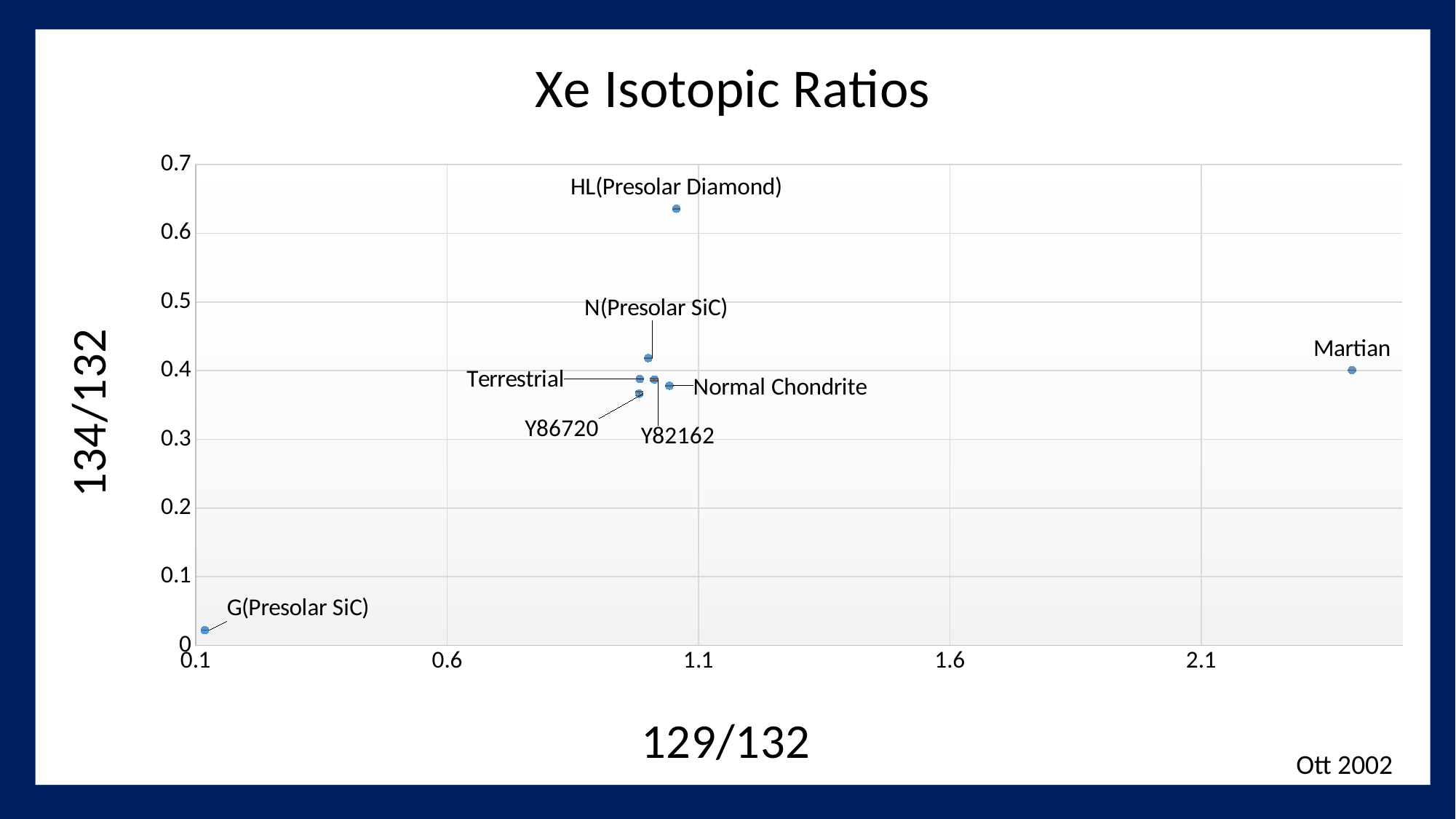
Which labelled point has the highest 134/132 value? HL(Presolar Diamond) Is the 134/132 value for HL(Presolar Diamond) greater or less than 0.6? greater What is the title of the chart? Xe Isotopic Ratios Which labelled point has the lowest 134/132 value? G(Presolar SiC) Is the 134/132 value for G(Presolar SiC) greater or less than 0.1? less Which labelled point has the lowest 129/132 value? G(Presolar SiC) Which labelled point has the highest 129/132 value? Martian What kind of chart is shown on the slide? scatter chart Is the 134/132 value for N(Presolar SiC) greater or less than 0.4? greater How many labelled data points are plotted on the chart? 8 Which has the larger 134/132 value, HL(Presolar Diamond) or N(Presolar SiC)? HL(Presolar Diamond)